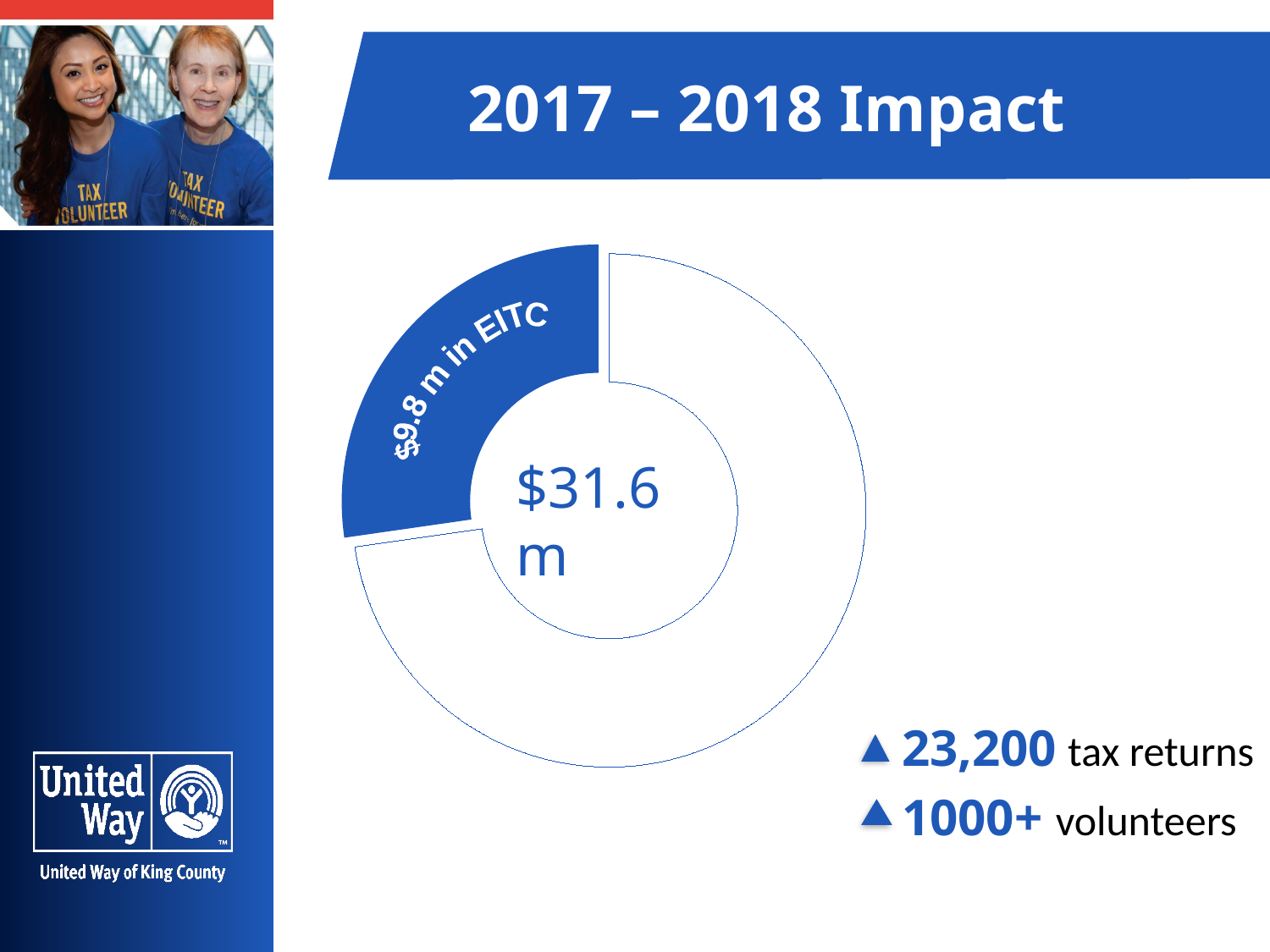
What is the title of the slide containing the doughnut chart? 2017 – 2018 Impact How many tax returns are reported in the text beside the chart? 23,200 What kind of chart is shown on the slide? doughnut chart Is the EITC slice larger or smaller than the remaining unlabelled slice of the doughnut? smaller How many slices does the doughnut chart have? 2 Does the EITC slice take up more or less than half of the doughnut? less What value is printed in the centre of the doughnut chart? $31.6 m What colour is the EITC slice of the doughnut chart? blue What value is printed on the highlighted blue slice of the doughnut chart? $9.8 m in EITC How many volunteers are reported in the text beside the chart? 1000+